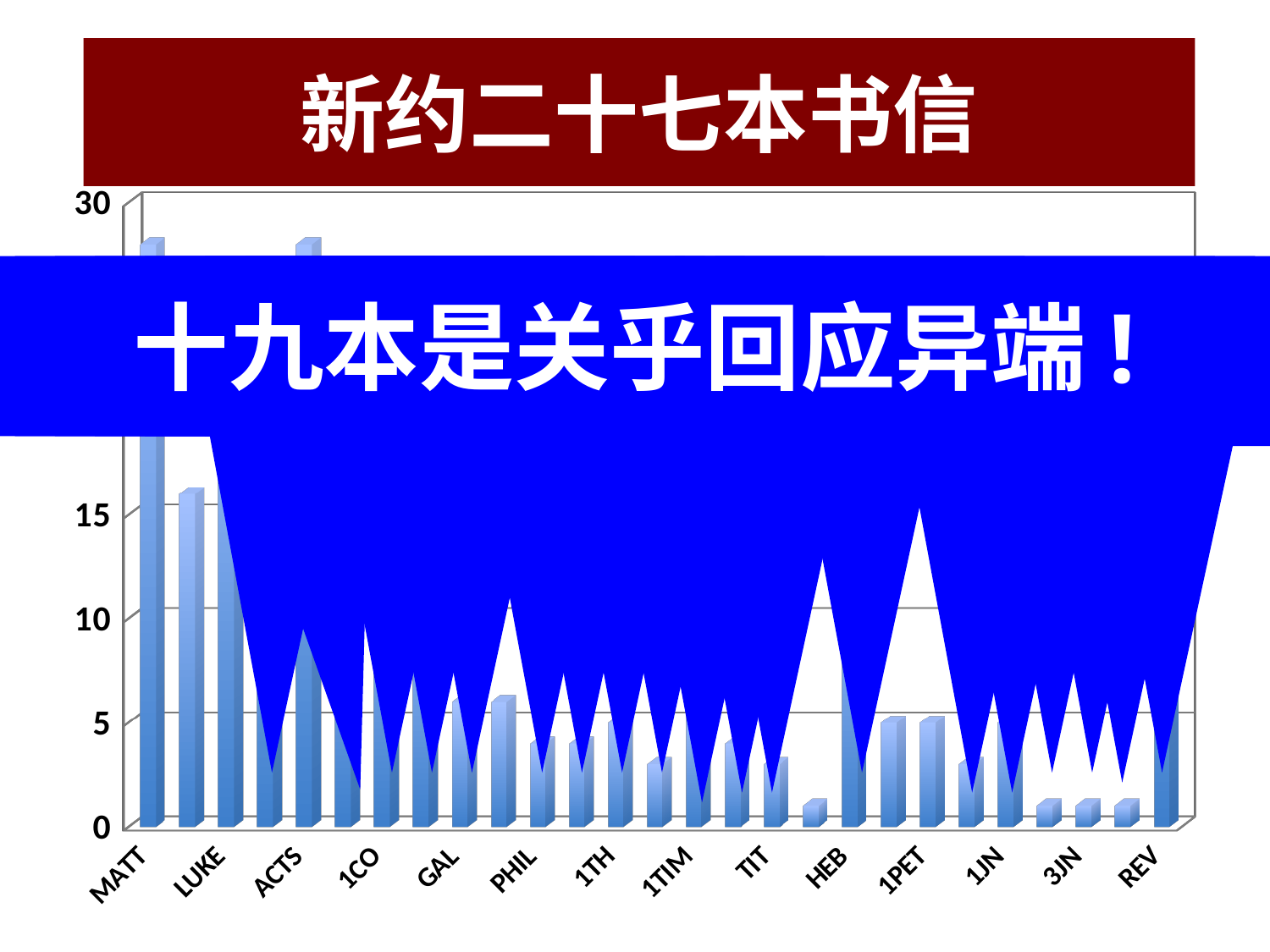
What is the first category label on the horizontal axis? MATT What kind of chart is shown on the slide? bar chart Is the value for 3JN greater or less than 5? less Is the value for PHIL greater or less than 10? less Which is larger, the value for ACTS or the value for 3JN? ACTS Is the value for LUKE greater or less than 10? greater What is the highest value shown on the vertical axis? 30